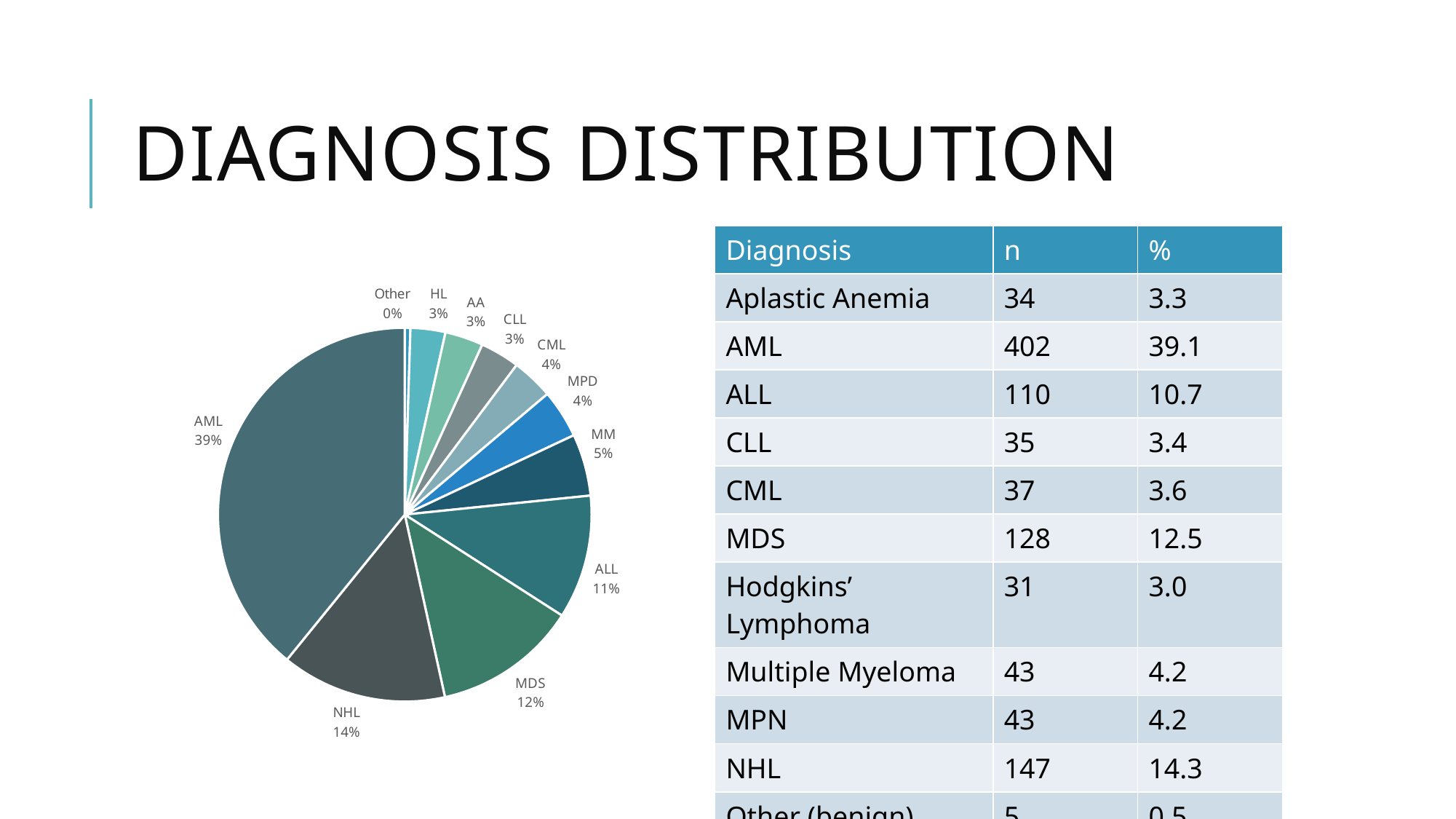
What percentage does the MM slice represent in the pie chart? 5% What is the combined percentage of the ALL and MDS slices in the pie chart? 23% What percentage does the NHL slice represent in the pie chart? 14% What percentage does the MDS slice represent in the pie chart? 12% Which slice is larger in the pie chart, ALL or MDS? MDS How many slices does the pie chart have? 11 Which diagnosis has the largest slice in the pie chart? AML What is the title of the slide containing the pie chart? DIAGNOSIS DISTRIBUTION What is the difference in percentage points between the AML slice and the NHL slice in the pie chart? 25 Which diagnosis has the smallest slice in the pie chart? Other What kind of chart is shown on the slide? pie chart What percentage does the AML slice represent in the pie chart? 39%